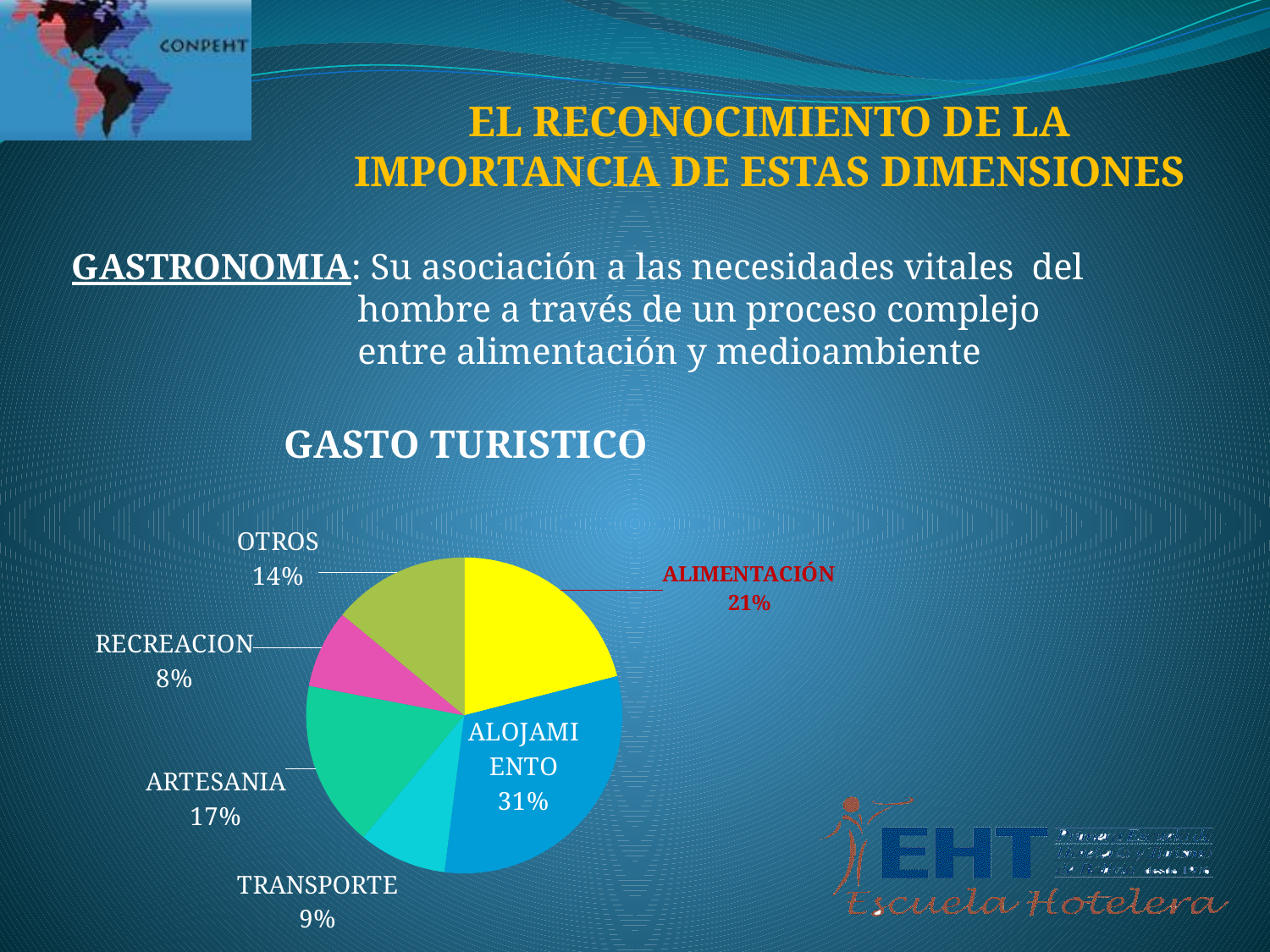
What percentage of the GASTO TURISTICO pie is ALOJAMIENTO? 31% How many slices does the GASTO TURISTICO pie chart have? 6 What percentage of the GASTO TURISTICO pie is ALIMENTACIÓN? 21% Which category has the largest share of the GASTO TURISTICO pie? ALOJAMIENTO What is the difference in percentage points between ALOJAMIENTO and ALIMENTACIÓN in the GASTO TURISTICO pie? 10 percentage points What kind of chart is shown under the heading GASTO TURISTICO? pie chart What percentage of the GASTO TURISTICO pie is RECREACION? 8% Which category has the smallest share of the GASTO TURISTICO pie? RECREACION Which is larger in the GASTO TURISTICO pie, ARTESANIA or OTROS? ARTESANIA What percentage of the GASTO TURISTICO pie is TRANSPORTE? 9% What percentage of the GASTO TURISTICO pie is OTROS? 14% What percentage of the GASTO TURISTICO pie is ARTESANIA? 17%